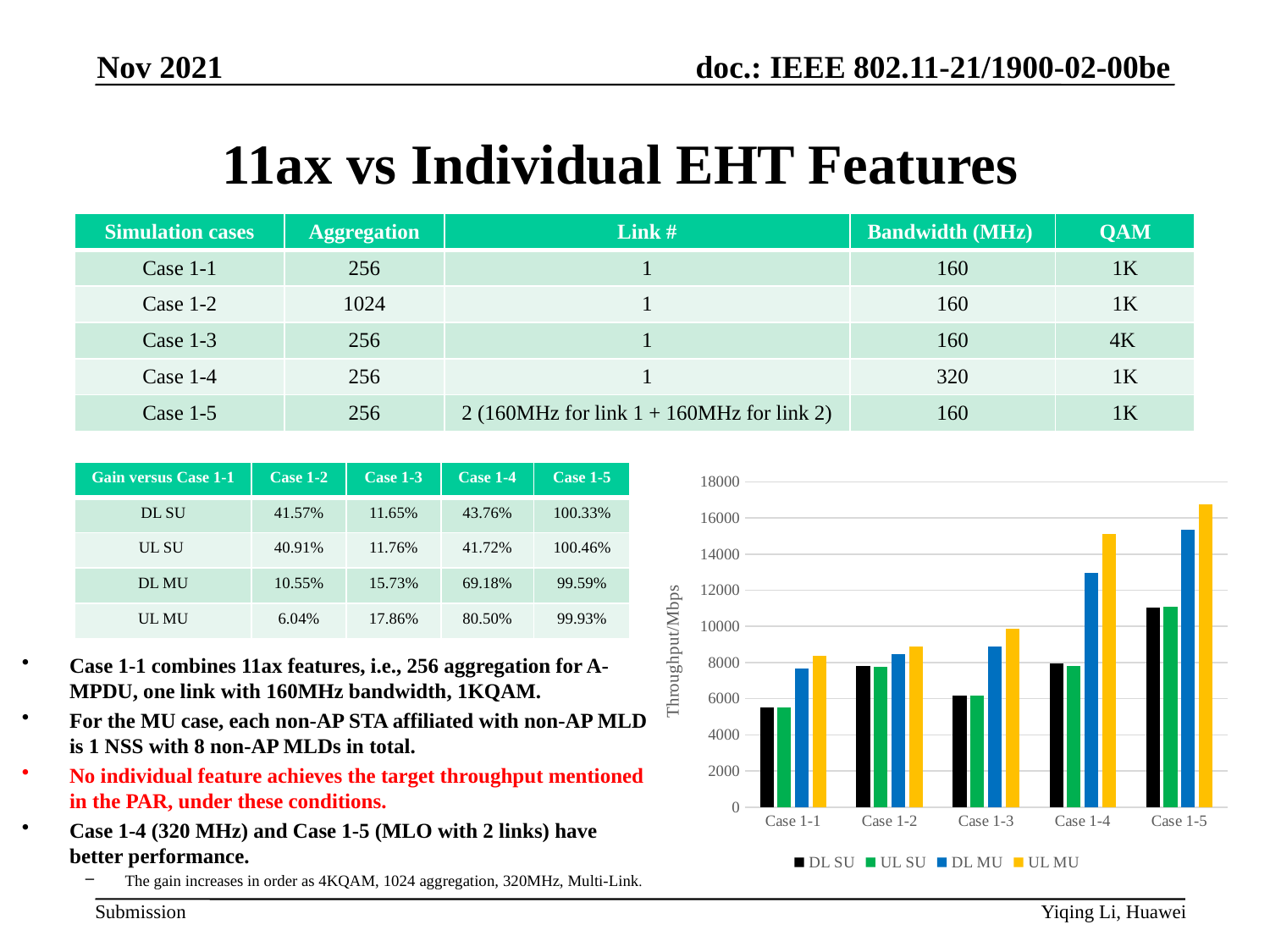
What is the label on the y axis of the chart? Throughput/Mbps Which case has the highest UL MU throughput in the chart? Case 1-5 What kind of chart is shown on the slide? bar chart Is the DL MU value for Case 1-4 greater or less than 12000? greater Which has the larger UL MU throughput, Case 1-3 or Case 1-4? Case 1-4 In Case 1-5, which is larger, DL MU or UL MU? UL MU How many simulation cases are plotted along the x axis of the chart? 5 Is the DL SU value for Case 1-1 greater or less than 6000? less How many series does the chart legend list? 4 Does the UL MU throughput rise or fall from Case 1-1 to Case 1-5? rise Which case has the lowest DL SU throughput in the chart? Case 1-1 Is the UL MU value for Case 1-5 greater or less than 16000? greater